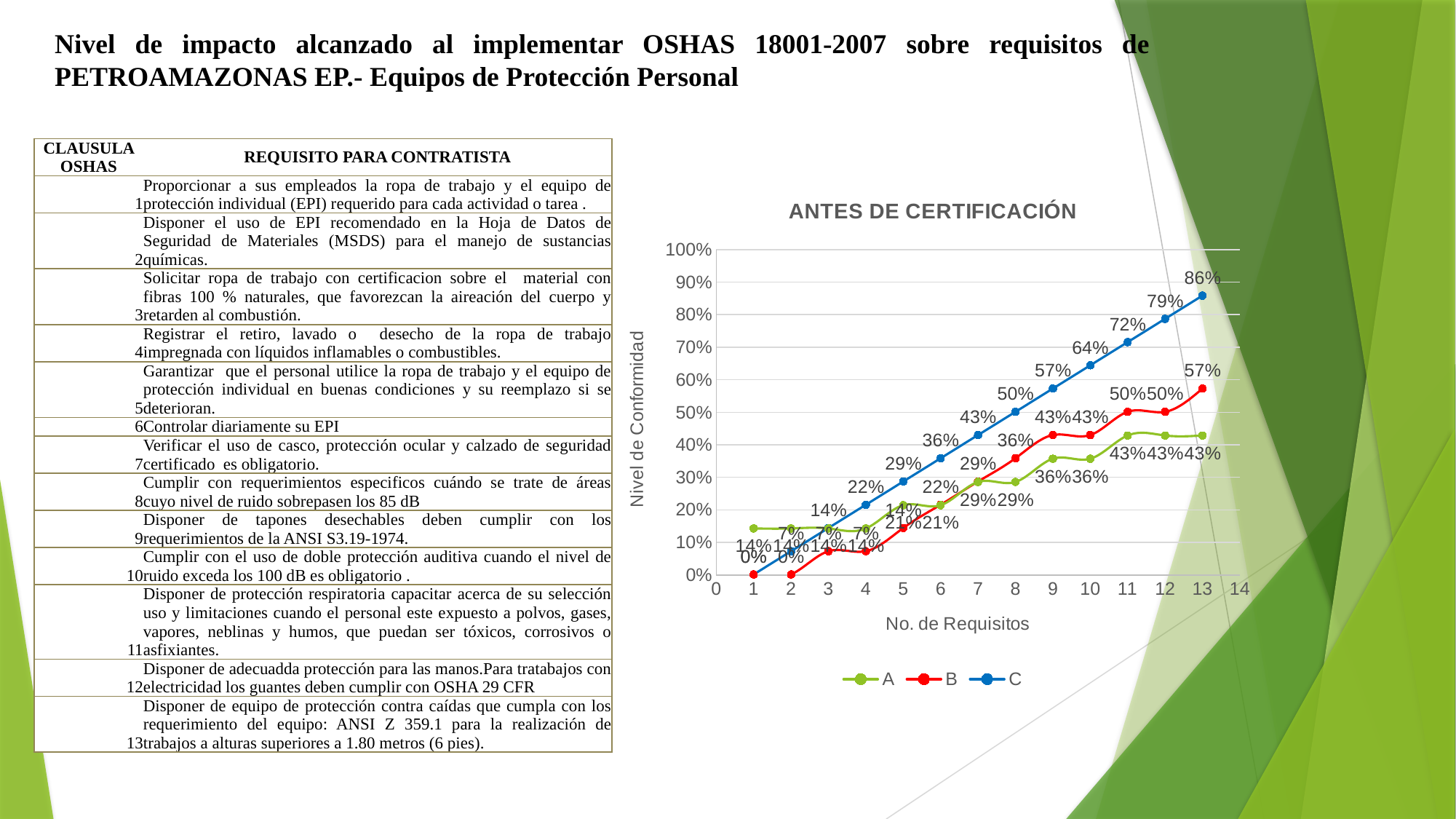
What is the value of series C at requisito 12? 79% Which series reaches the highest value at requisito 13? C What is the title of the chart? ANTES DE CERTIFICACIÓN What is the value of series B at requisito 13? 57% Is the value of series C at requisito 11 greater or less than 70%? greater What type of chart is shown on the slide? line chart What is the value of series C at requisito 13? 86% Do the values of series C rise or fall as the number of requisitos increases? rise What is the label of the y axis of the chart? Nivel de Conformidad How many series does the legend of the chart list? 3 What is the difference between series C and series B at requisito 13? 29% What is the value of series C at requisito 8? 50%